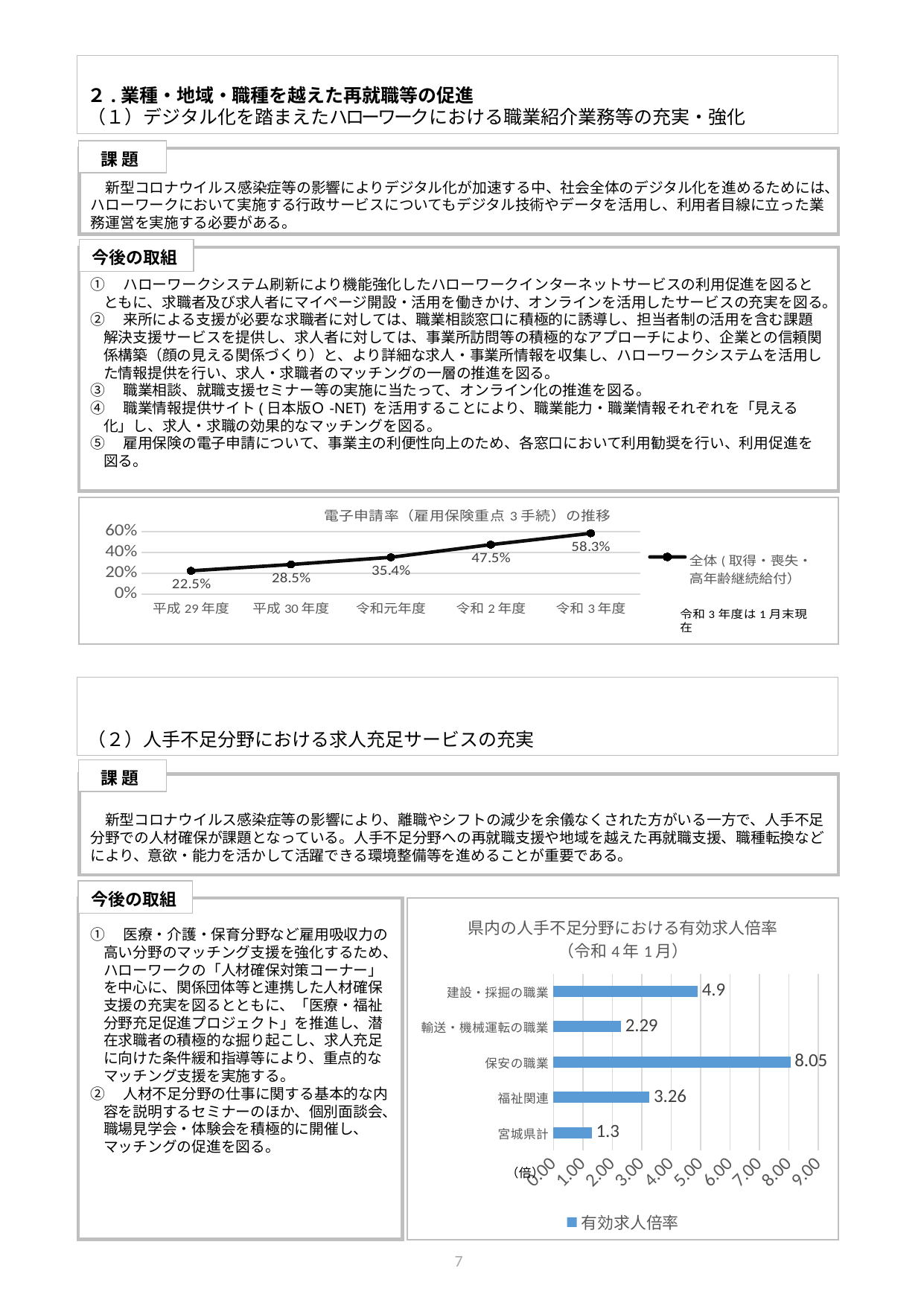
In the line chart titled 電子申請率（雇用保険重点３手続）の推移, do the values rise or fall from 平成29年度 to 令和３年度? rise In the line chart titled 電子申請率（雇用保険重点３手続）の推移, what is the value for 平成29年度? 22.5% What kind of chart is the chart titled 電子申請率（雇用保険重点３手続）の推移? line chart In the line chart titled 電子申請率（雇用保険重点３手続）の推移, what is the value for 令和３年度? 58.3% In the bar chart titled 県内の人手不足分野における有効求人倍率, which category has the highest value? 保安の職業 In the bar chart titled 県内の人手不足分野における有効求人倍率, which is larger, 建設・採掘の職業 or 輸送・機械運転の職業? 建設・採掘の職業 In the line chart titled 電子申請率（雇用保険重点３手続）の推移, how many data points are plotted? 5 In the line chart titled 電子申請率（雇用保険重点３手続）の推移, what is the difference between the values for 令和２年度 and 令和元年度? 12.1% In the bar chart titled 県内の人手不足分野における有効求人倍率, what is the difference between 保安の職業 and 宮城県計? 6.75 In the bar chart titled 県内の人手不足分野における有効求人倍率, how many series does the legend list? 1 In the bar chart titled 県内の人手不足分野における有効求人倍率, which category has the lowest value? 宮城県計 In the bar chart titled 県内の人手不足分野における有効求人倍率, what is the value for 福祉関連? 3.26